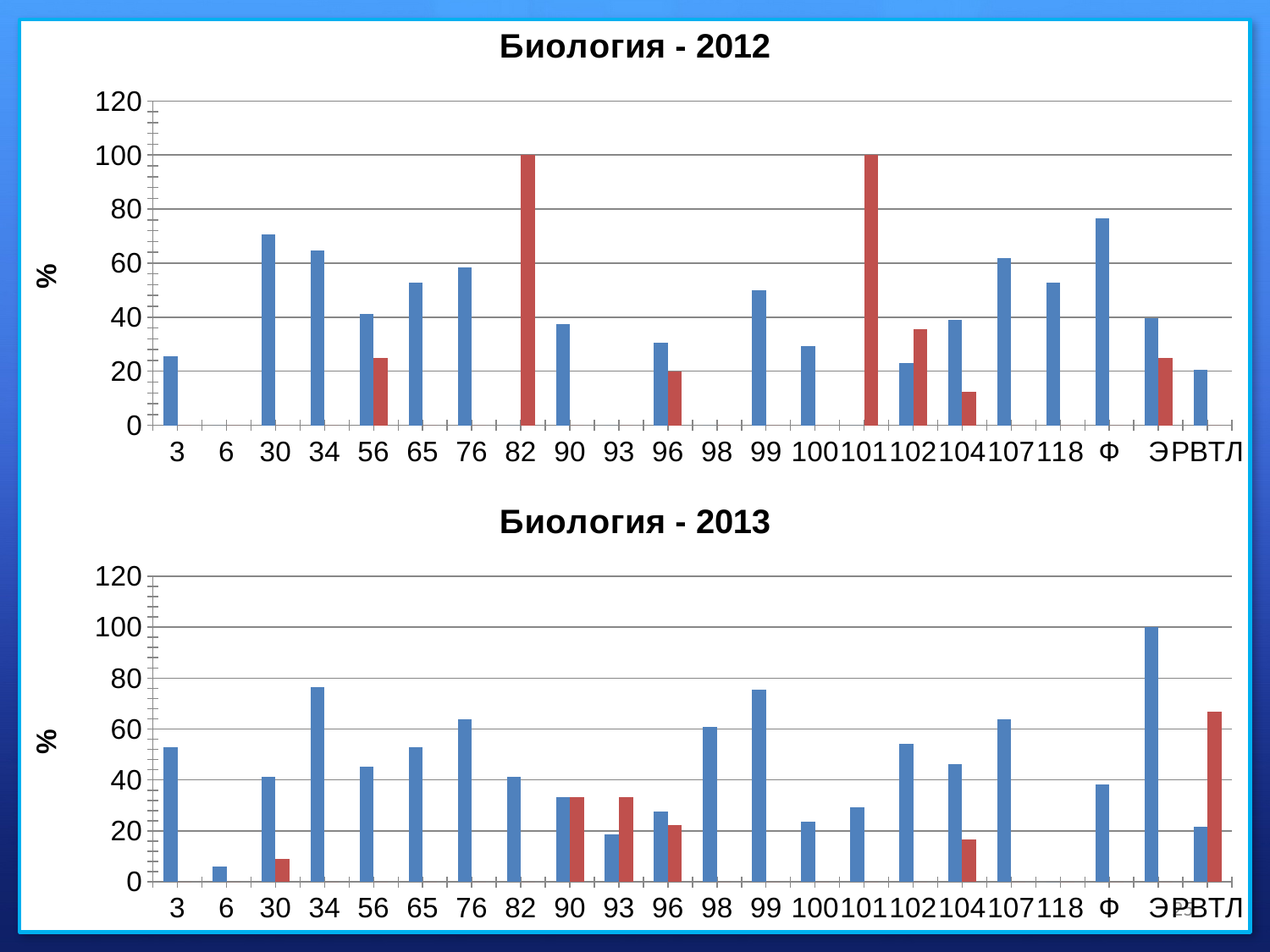
In the "Биология - 2013" chart, which category has the lowest blue bar? 6 In the "Биология - 2012" chart, what is the value of the red bar for category 82? 100 In the "Биология - 2012" chart, which has the larger blue bar, category 3 or category 30? 30 In the "Биология - 2013" chart, which category has the highest blue bar? Э In the "Биология - 2013" chart, is the blue bar for category 34 greater or less than 60? greater In the "Биология - 2012" chart, is the blue bar for category 30 greater or less than 60? greater What kind of chart is the "Биология - 2012" chart? bar chart How many categories are shown on the x axis of the "Биология - 2013" chart? 22 In the "Биология - 2013" chart, which has the larger blue bar, category 98 or category 99? 99 What is the label on the vertical axis of the "Биология - 2012" chart? %